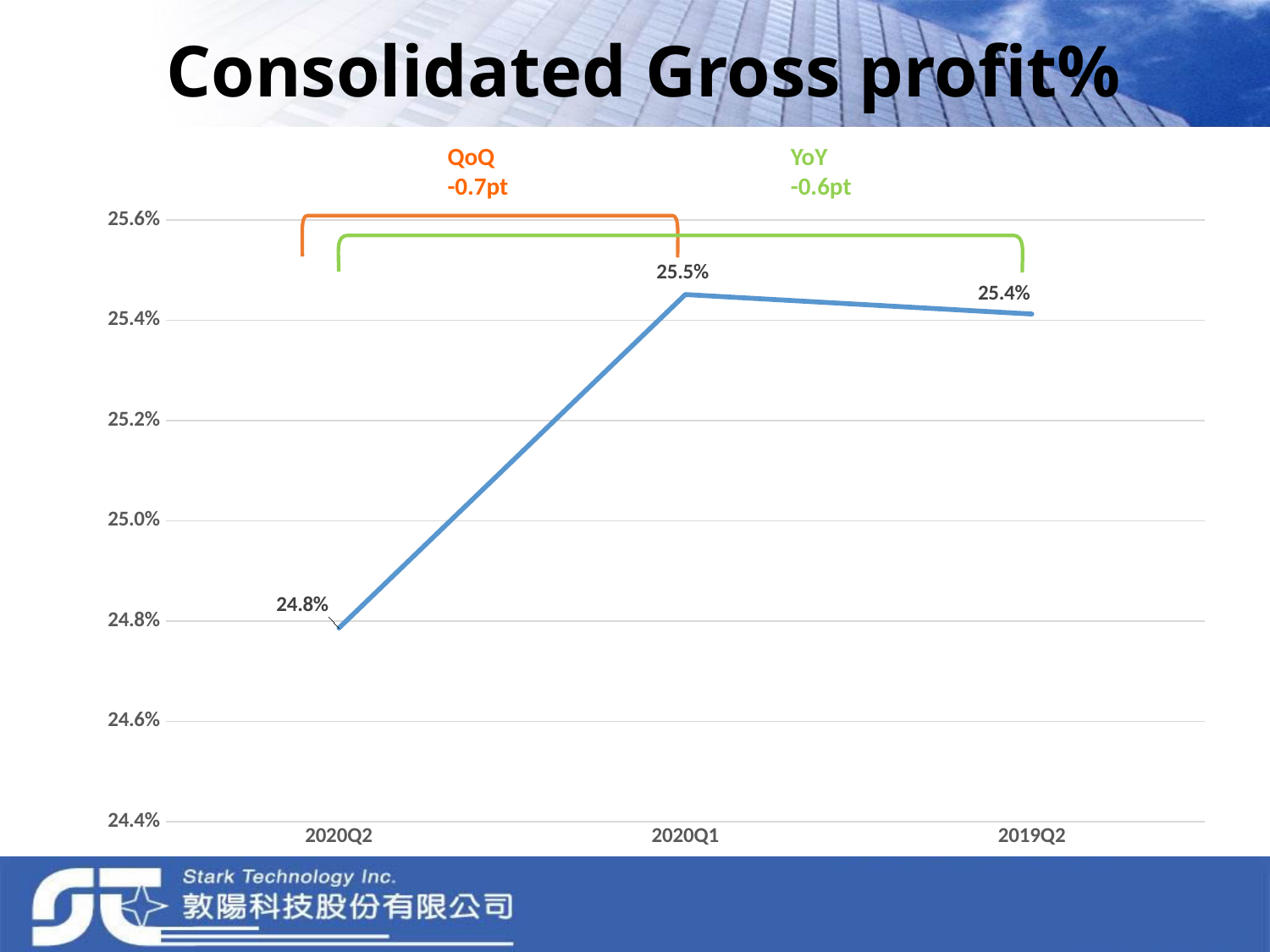
What is the difference in gross profit % between 2019Q2 and 2020Q2? 0.6pt Which quarter has the highest consolidated gross profit %? 2020Q1 Which quarter has the lowest consolidated gross profit %? 2020Q2 What kind of chart is shown on the slide? line chart Which is larger, the gross profit % for 2020Q1 or for 2019Q2? 2020Q1 How many quarters are plotted on the chart? 3 What is the difference in gross profit % between 2020Q1 and 2020Q2? 0.7pt What is the consolidated gross profit % for 2019Q2? 25.4% Is the gross profit % for 2020Q2 greater or less than 25.0%? less What is the consolidated gross profit % for 2020Q1? 25.5% What is the consolidated gross profit % for 2020Q2? 24.8% What QoQ change is annotated on the chart? -0.7pt